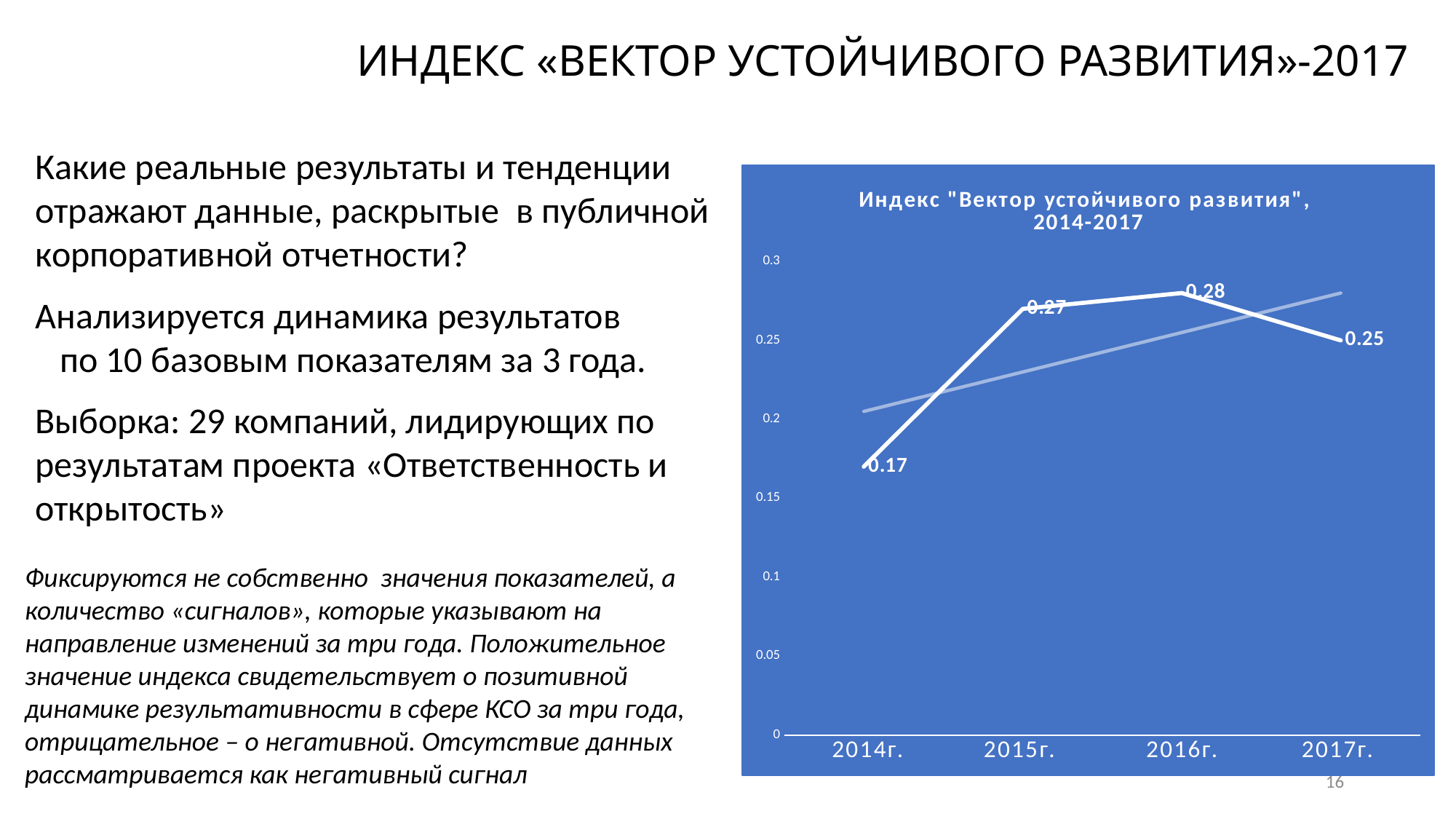
Which is larger, the index value for 2017г. or for 2014г.? 2017г. What is the index value for 2014г.? 0.17 What is the index value for 2017г.? 0.25 Which year has the highest index value? 2016г. What is the difference between the index values for 2015г. and 2014г.? 0.1 Which year has the lowest index value? 2014г. What type of chart is shown on the slide? Line chart Does the index value rise or fall from 2016г. to 2017г.? Fall What is the index value for 2016г.? 0.28 How many years are plotted on the x axis? 4 What is the index value for 2015г.? 0.27 What is the title of the chart? Индекс "Вектор устойчивого развития", 2014-2017